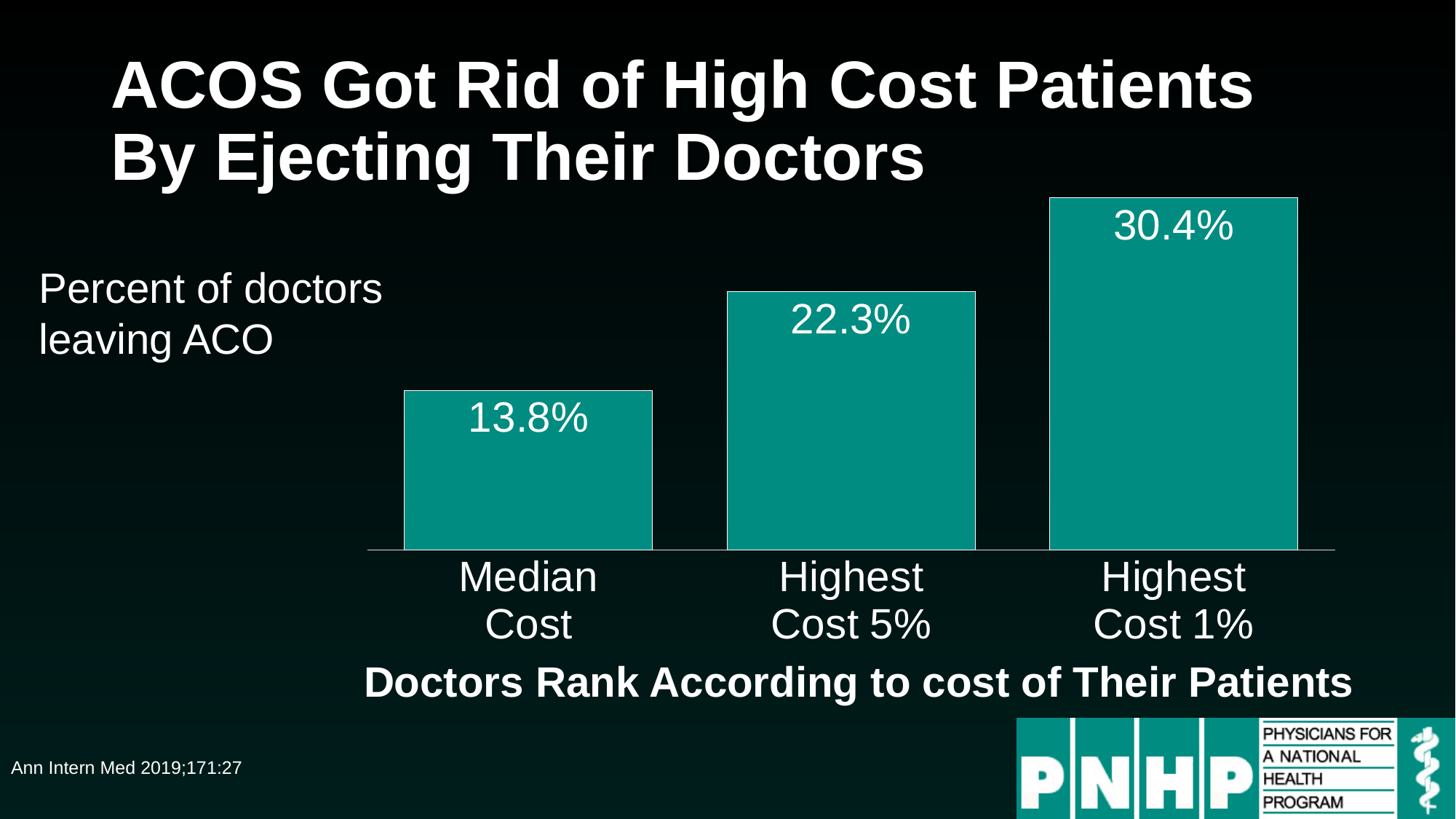
What percent of doctors ranked at Median Cost left the ACO? 13.8% Which category has the lowest percent of doctors leaving the ACO? Median Cost Which is larger, the value for Highest Cost 5% or the value for Median Cost? Highest Cost 5% What is the value for the Highest Cost 1% category? 30.4% How many categories are shown on the x axis of the chart? 3 What is the x-axis title of the chart? Doctors Rank According to cost of Their Patients What is the difference between the Highest Cost 1% and Median Cost values? 16.6% What is the value for the Highest Cost 5% category? 22.3% What is the difference between the Highest Cost 5% and Median Cost values? 8.5% Which category has the highest percent of doctors leaving the ACO? Highest Cost 1% Do the values rise or fall moving from Median Cost to Highest Cost 1% along the x axis? Rise What kind of chart is shown on the slide? Bar chart